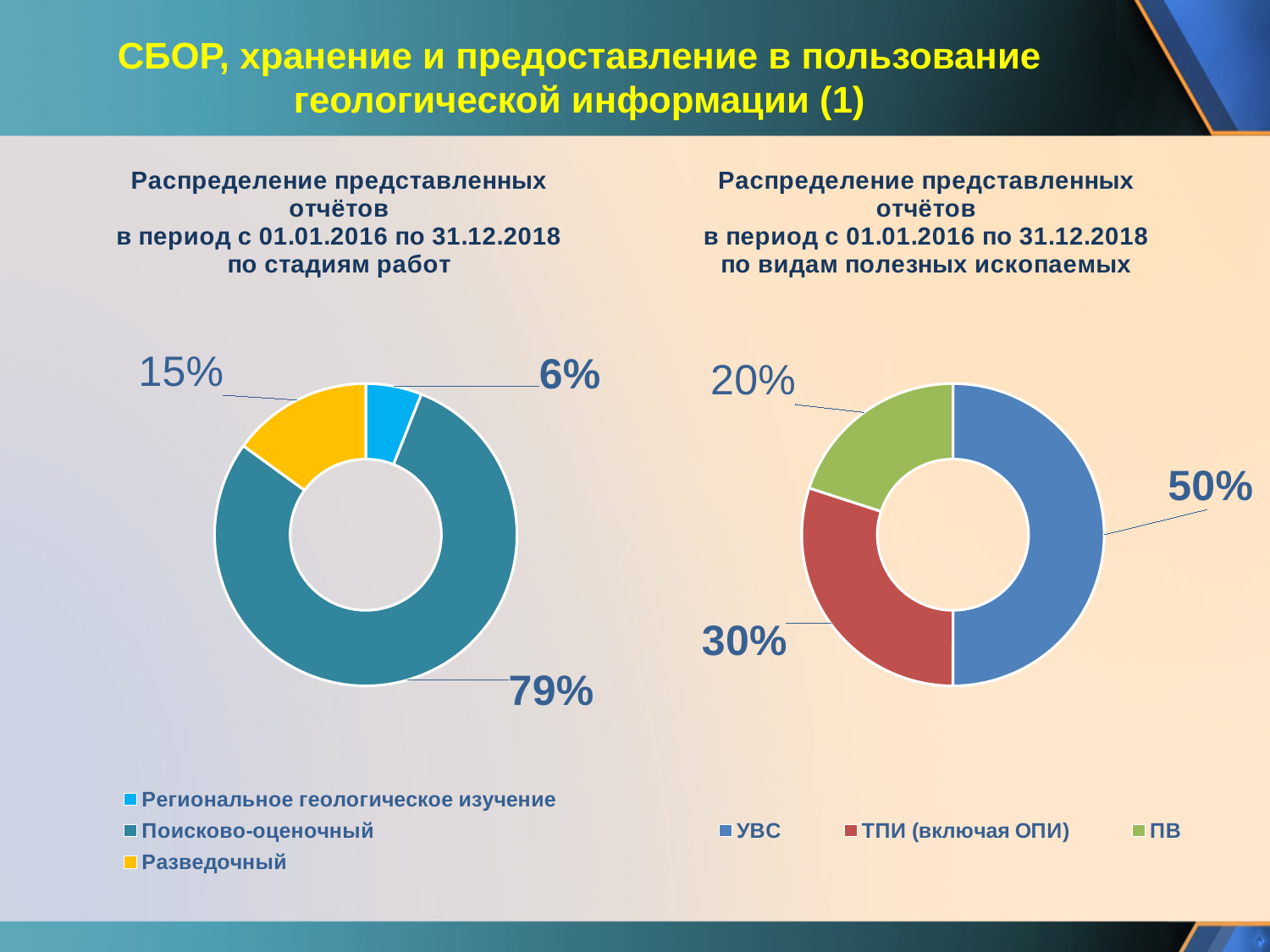
In the left chart (по стадиям работ), what is the difference in percentage points between Поисково-оценочный and Разведочный? 64 In the left chart (по стадиям работ), which category has the smallest share? Региональное геологическое изучение In the left chart (по стадиям работ), which category has the largest share? Поисково-оценочный In the right chart (по видам полезных ископаемых), what share of reports is УВС? 50% In the left chart (по стадиям работ), what share of reports is Региональное геологическое изучение? 6% In the right chart (по видам полезных ископаемых), what share of reports is ТПИ (включая ОПИ)? 30% In the right chart (по видам полезных ископаемых), which category has the smallest share? ПВ In the left chart (по стадиям работ), what share of reports is Поисково-оценочный? 79% What type of chart is the left chart (по стадиям работ)? Doughnut (pie) chart In the right chart (по видам полезных ископаемых), which is larger: ТПИ (включая ОПИ) or ПВ? ТПИ (включая ОПИ) How many categories does the legend of the right chart (по видам полезных ископаемых) list? 3 In the left chart (по стадиям работ), what share of reports is Разведочный? 15%